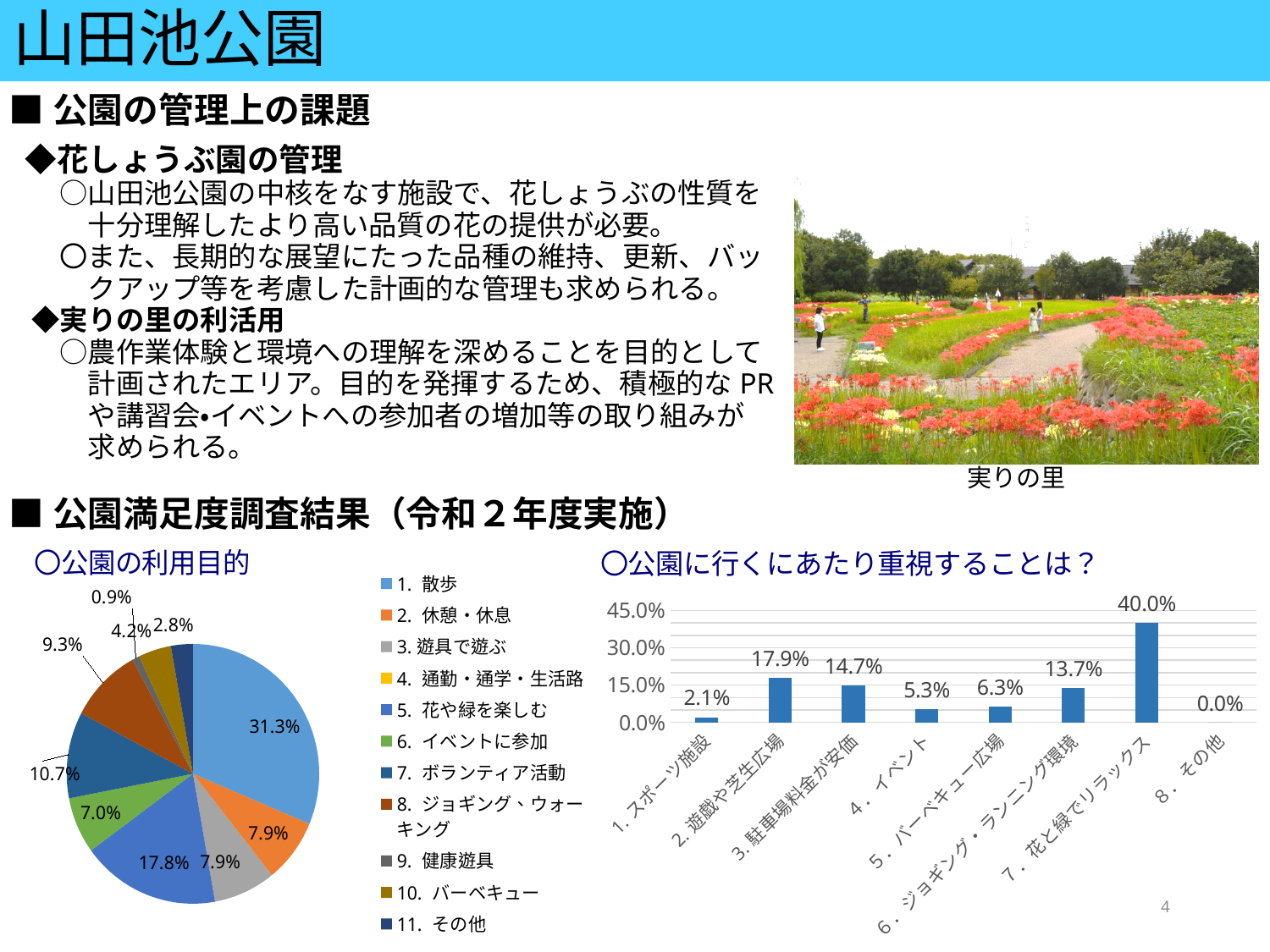
In the bar chart titled 公園に行くにあたり重視することは？, which category has the lowest value? 8. その他 In the bar chart titled 公園に行くにあたり重視することは？, what is the difference between the values for 2. 遊戯や芝生広場 and 3. 駐車場料金が安価? 3.2% In the bar chart titled 公園に行くにあたり重視することは？, which is larger: 4. イベント or 5. バーベキュー広場? 5. バーベキュー広場 In the bar chart titled 公園に行くにあたり重視することは？, which category has the highest value? 7. 花と緑でリラックス How many entries does the legend of the pie chart titled 公園の利用目的 list? 11 In the bar chart titled 公園に行くにあたり重視することは？, how many categories are shown? 8 In the bar chart titled 公園に行くにあたり重視することは？, what is the value for 3. 駐車場料金が安価? 14.7% In the pie chart titled 公園の利用目的, what is the largest slice's share? 31.3% In the bar chart titled 公園に行くにあたり重視することは？, what is the value for 1. スポーツ施設? 2.1% In the bar chart titled 公園に行くにあたり重視することは？, what is the value for 2. 遊戯や芝生広場? 17.9% What kind of chart is the chart titled 公園に行くにあたり重視することは？? bar chart In the bar chart titled 公園に行くにあたり重視することは？, what is the value for 7. 花と緑でリラックス? 40.0%